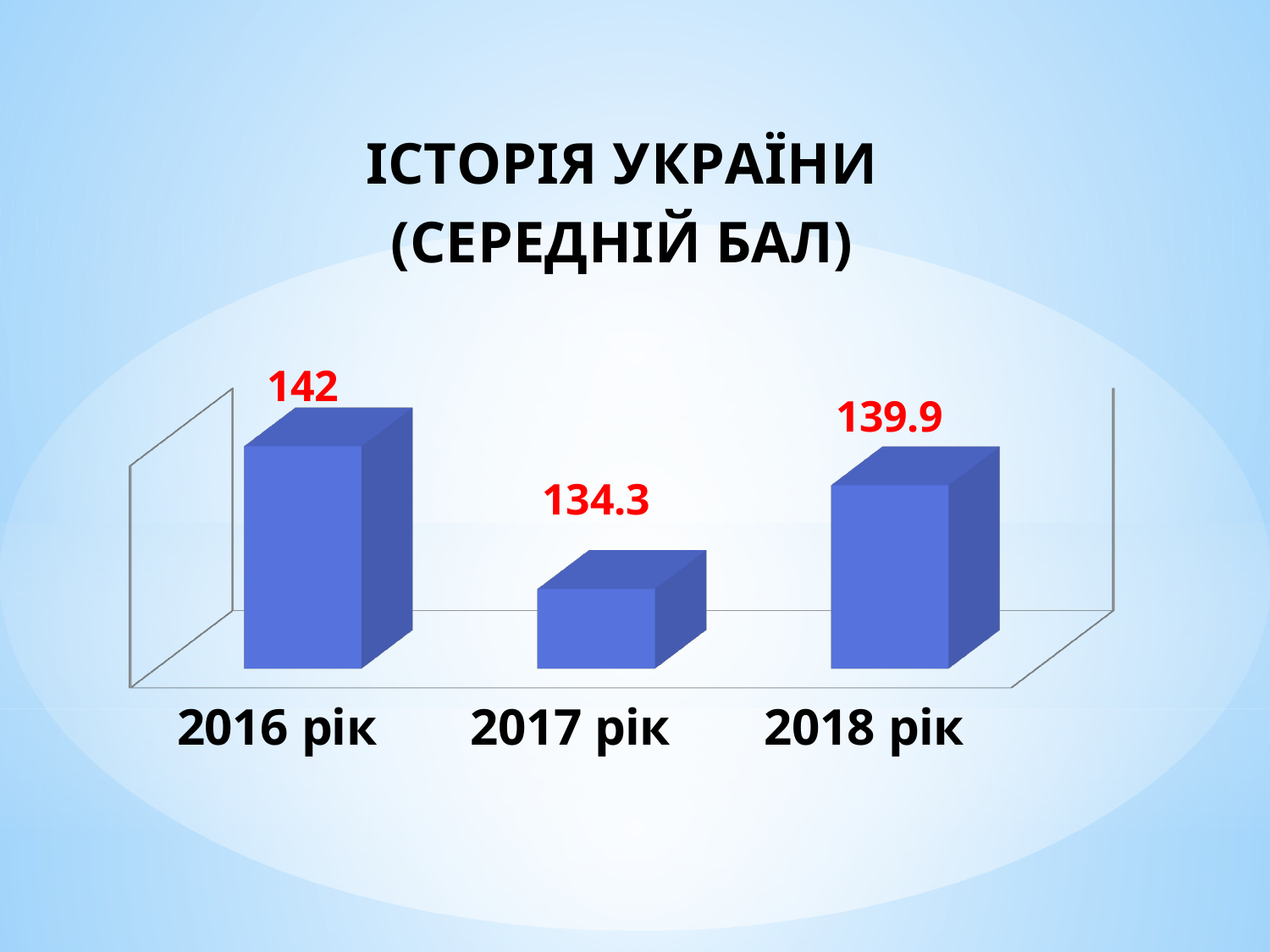
What is the average score shown for 2016 рік? 142 What is the title of the chart? ІСТОРІЯ УКРАЇНИ (СЕРЕДНІЙ БАЛ) What kind of chart is shown on the slide? Bar chart What is the value shown for 2018 рік? 139.9 What is the value shown for 2017 рік? 134.3 What is the difference between the values for 2016 рік and 2017 рік? 7.7 Which year has the highest average score? 2016 рік What is the difference between the values for 2016 рік and 2018 рік? 2.1 Which is larger, the value for 2017 рік or the value for 2018 рік? 2018 рік What is the difference between the values for 2018 рік and 2017 рік? 5.6 How many years (categories) are shown in the chart? 3 Which year has the lowest average score? 2017 рік